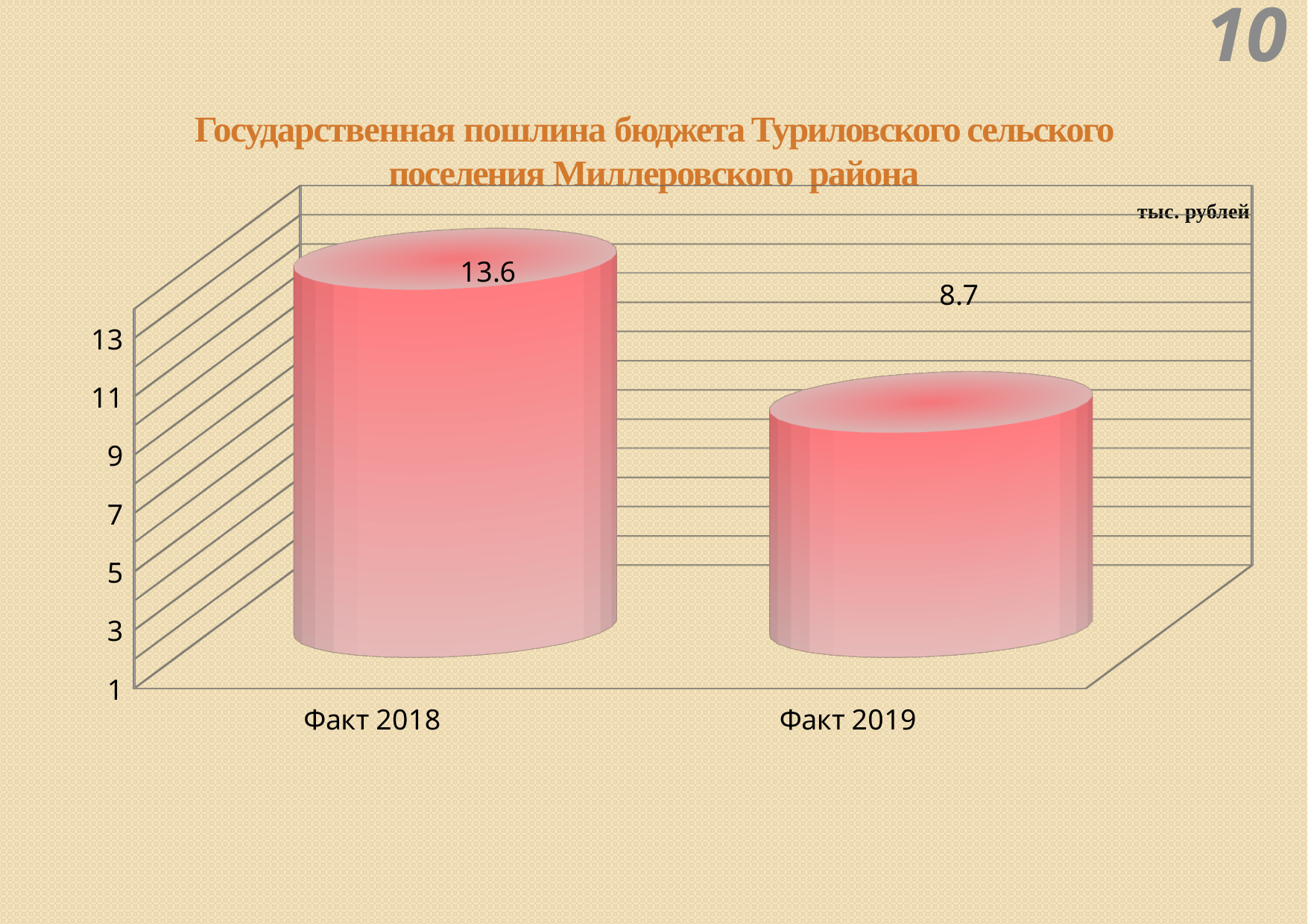
How many categories are shown on the chart? 2 Which is larger, the value for Факт 2018 or the value for Факт 2019? Факт 2018 What is the value for Факт 2018? 13.6 Which category has the lowest value? Факт 2019 What is the value for Факт 2019? 8.7 What unit is indicated on the chart? тыс. рублей Which category has the highest value? Факт 2018 Do the values rise or fall from Факт 2018 to Факт 2019? fall Is the value for Факт 2018 greater or less than 11? greater Is the value for Факт 2019 greater or less than 11? less What is the difference between the values for Факт 2018 and Факт 2019? 4.9 What kind of chart is shown on the slide? bar chart